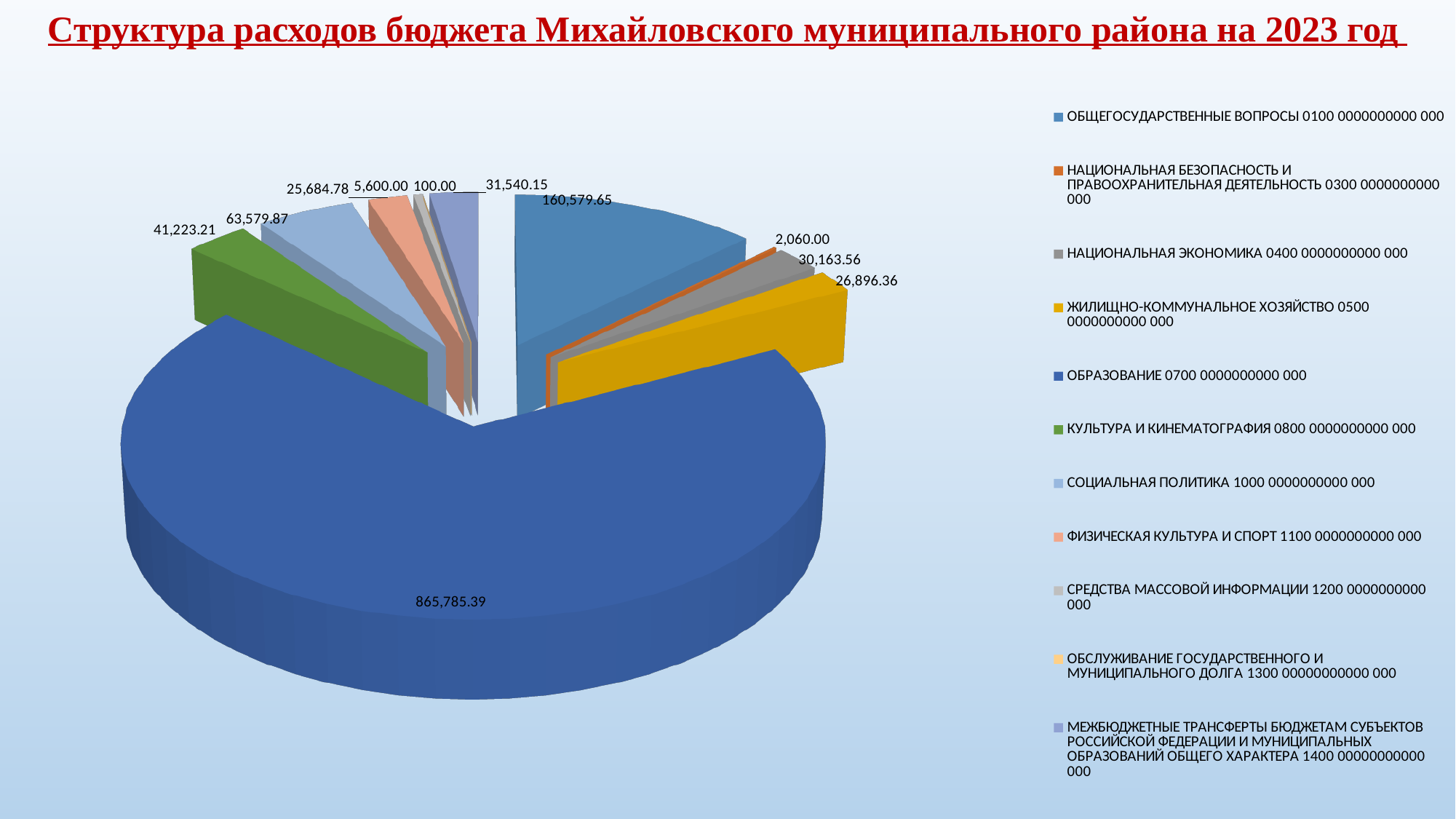
What is the value for ОБРАЗОВАНИЕ 0700? 865,785.39 Which category has the smallest value? ОБСЛУЖИВАНИЕ ГОСУДАРСТВЕННОГО И МУНИЦИПАЛЬНОГО ДОЛГА 1300 What is the value for ОБЩЕГОСУДАРСТВЕННЫЕ ВОПРОСЫ 0100? 160,579.65 What type of chart is shown on the slide? Pie chart What is the value for КУЛЬТУРА И КИНЕМАТОГРАФИЯ 0800? 41,223.21 What is the value for СОЦИАЛЬНАЯ ПОЛИТИКА 1000? 63,579.87 Which category has the largest slice of the pie? ОБРАЗОВАНИЕ 0700 How many categories does the pie chart contain? 11 What is the value for ЖИЛИЩНО-КОММУНАЛЬНОЕ ХОЗЯЙСТВО 0500? 26,896.36 What is the title of the slide? Структура расходов бюджета Михайловского муниципального района на 2023 год Which is larger: the value for НАЦИОНАЛЬНАЯ ЭКОНОМИКА 0400 or the value for ФИЗИЧЕСКАЯ КУЛЬТУРА И СПОРТ 1100? НАЦИОНАЛЬНАЯ ЭКОНОМИКА 0400 What is the difference between the values for ОБЩЕГОСУДАРСТВЕННЫЕ ВОПРОСЫ 0100 and СОЦИАЛЬНАЯ ПОЛИТИКА 1000? 96,999.78